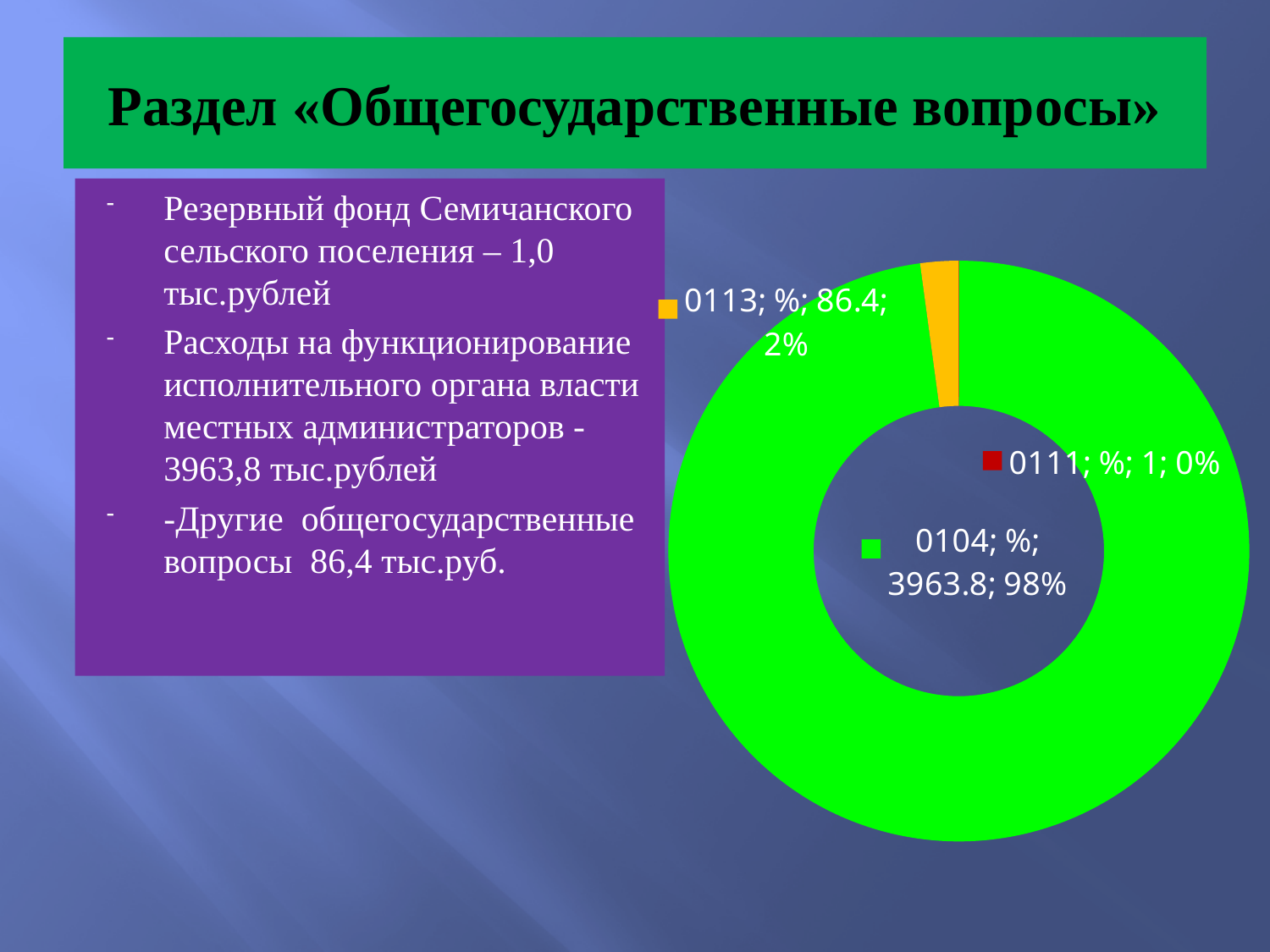
Which category has the largest slice in the doughnut chart? 0104 What colour is the slice for category 0104 in the doughnut chart? green What kind of chart is shown on the slide? doughnut chart How many slices does the doughnut chart have? 3 What is the value shown for category 0104 in the doughnut chart? 3963.8 What percentage share does category 0104 have in the doughnut chart? 98% What percentage share does category 0113 have in the doughnut chart? 2% Which category has the smallest slice in the doughnut chart? 0111 What is the difference between the values for 0104 and 0113 in the doughnut chart? 3877.4 What percentage share does category 0111 have in the doughnut chart? 0% What is the value shown for category 0113 in the doughnut chart? 86.4 What is the value shown for category 0111 in the doughnut chart? 1